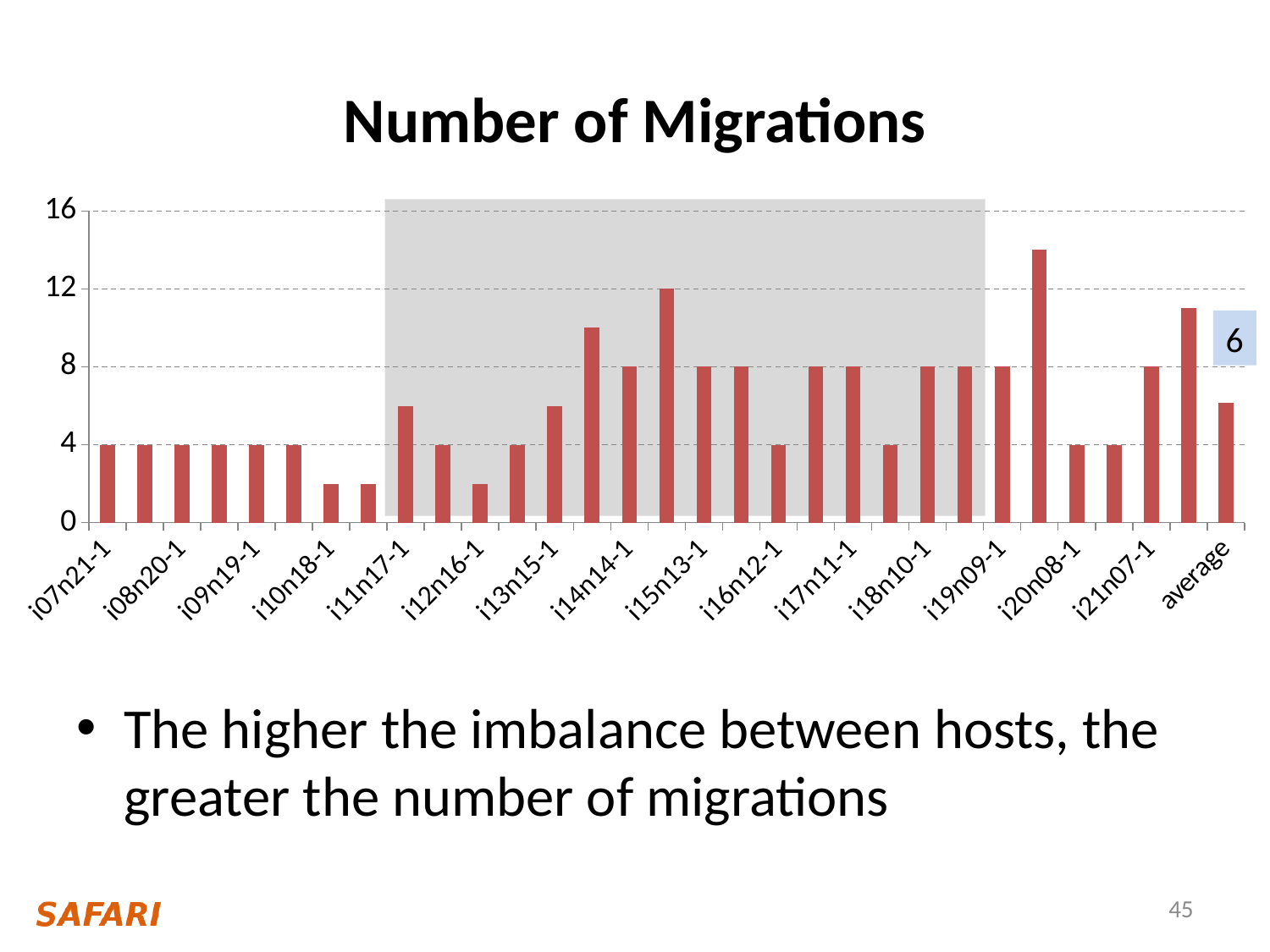
Is the value for i10n18-1 greater or less than 4? less Which has more migrations, i14n14-1 or i07n21-1? i14n14-1 What is the title of the chart? Number of Migrations What type of chart is shown on the slide? bar chart What is the number of migrations for i17n11-1? 8 Is the tallest bar in the chart greater or less than 12? greater What is the value of the average bar? 6 How many category labels are shown on the x axis? 16 Is the value for i11n17-1 greater or less than 4? greater What is the number of migrations for i14n14-1? 8 What is the difference in migrations between i14n14-1 and i07n21-1? 4 What is the number of migrations for i07n21-1? 4